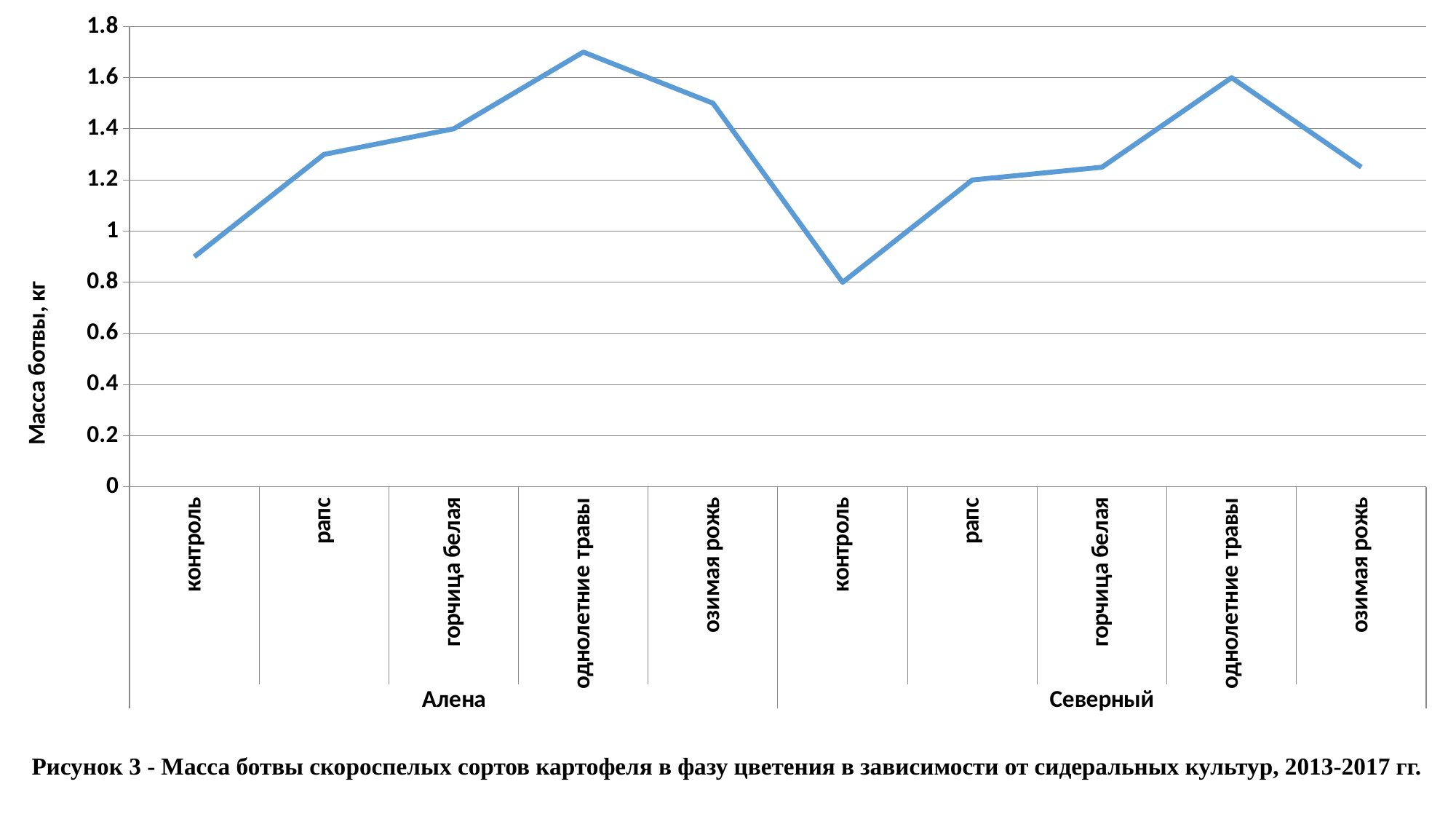
How many data points are plotted on the line? 10 What is the value for однолетние травы in the Северный group? 1.6 What is the value for горчица белая in the Алена group? 1.4 What is the value for контроль in the Северный group? 0.8 What type of chart is shown on the slide? line chart Is the value for однолетние травы in the Алена group greater or less than 1.6? greater What is the difference between однолетние травы and контроль in the Северный group? 0.8 What is the y-axis title of the chart? Масса ботвы, кг Which category has the highest value on the chart? однолетние травы (Алена) What is the value for рапс in the Северный group? 1.2 Which category has the lowest value on the chart? контроль (Северный) Which is larger: контроль for Алена or контроль for Северный? контроль for Алена